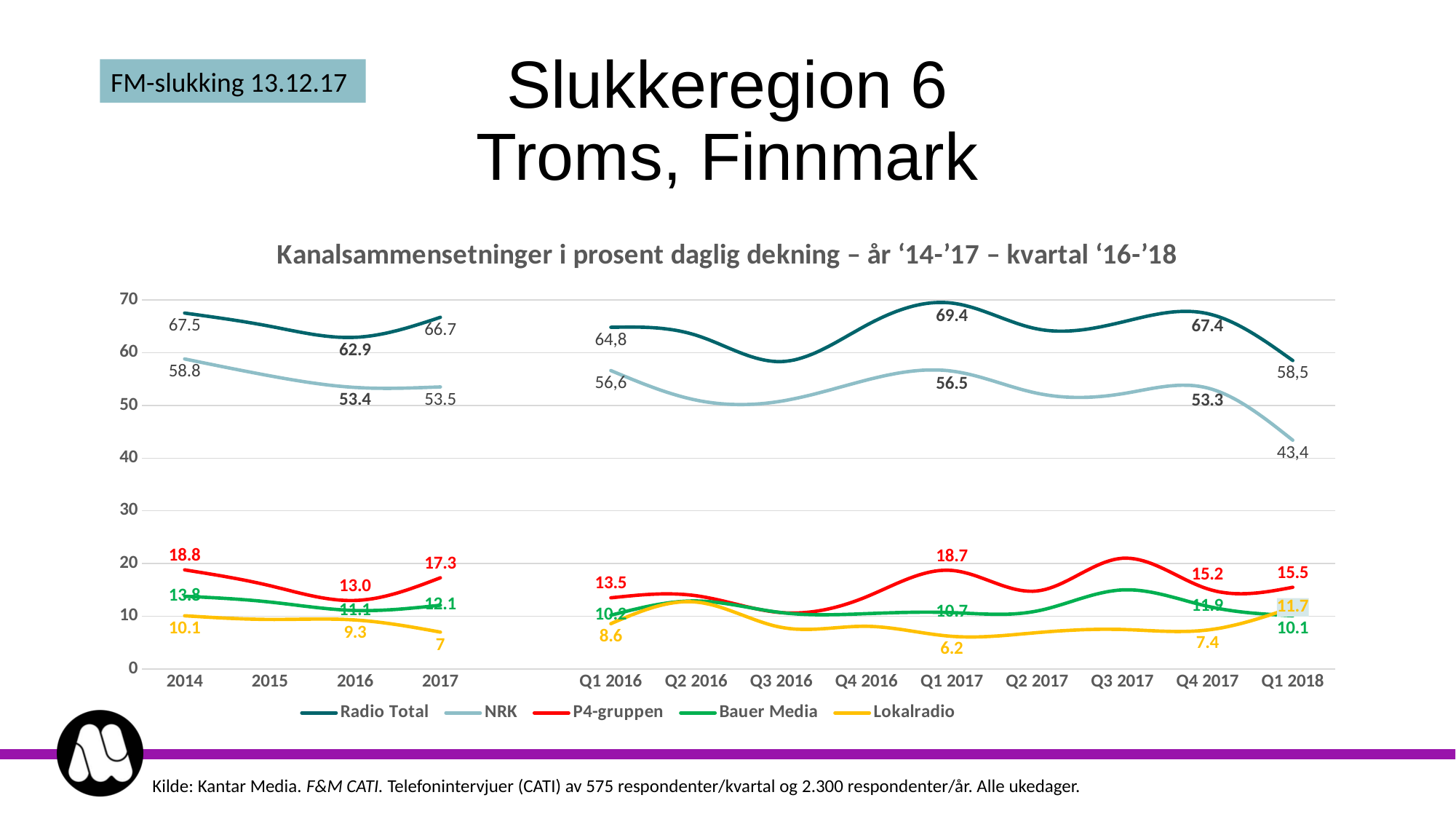
What type of chart is shown on the slide? line chart Is the value for NRK in Q3 2016 greater or less than 60? less What is the value for P4-gruppen in Q1 2017? 18.7 Which is larger, the NRK value in 2014 or the NRK value in 2017? 2014 What is the value for Radio Total in Q1 2018? 58,5 Which series has the lowest value in 2017? Lokalradio What is the value for NRK in Q1 2018? 43,4 How many series does the legend list? 5 What is the value for Lokalradio in Q1 2017? 6.2 What is the difference between the Radio Total values in Q1 2017 and Q1 2018? 10.9 What is the value for Radio Total in 2014? 67.5 Which series has the highest value in Q1 2017? Radio Total